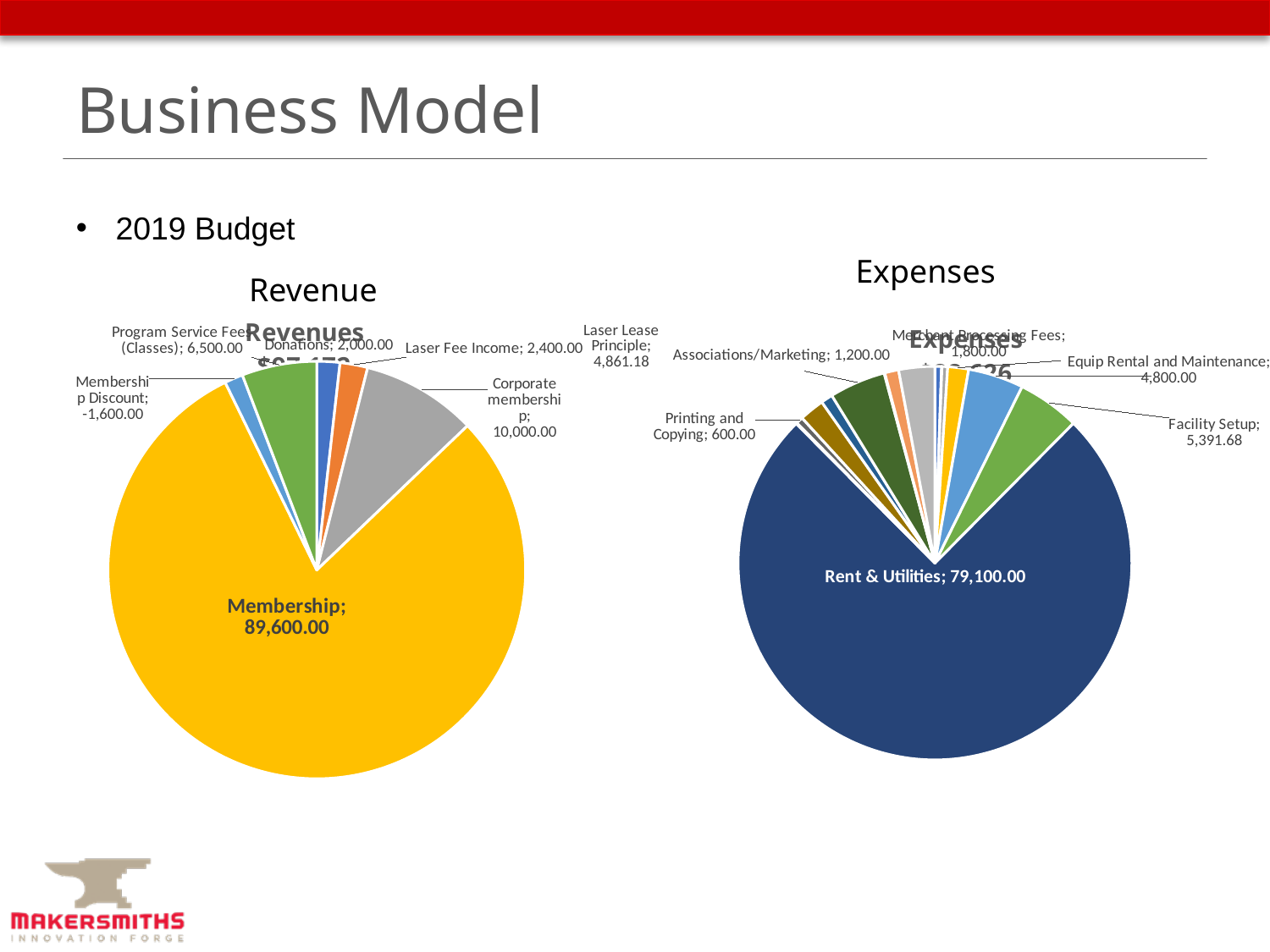
In the Revenue pie chart, which is larger: Donations or Laser Fee Income? Laser Fee Income In the Revenue pie chart, which category has the largest slice? Membership In the Expenses pie chart, what is the difference between Equip Rental and Maintenance and Associations/Marketing? 3,600.00 In the Expenses pie chart, which is larger: Facility Setup or Equip Rental and Maintenance? Facility Setup What type of chart is used for the Revenue and Expenses data on the slide? Pie chart In the Revenue pie chart, what is the value for Membership? 89,600.00 In the Expenses pie chart, which category has the largest slice? Rent & Utilities In the Expenses pie chart, what is the value for Facility Setup? 5,391.68 In the Expenses pie chart, what is the value for Rent & Utilities? 79,100.00 In the Revenue pie chart, what is the difference between Corporate membership and Laser Fee Income? 7,600.00 In the Expenses pie chart, what is the value for Laser Lease Principle? 4,861.18 In the Revenue pie chart, what is the value for Corporate membership? 10,000.00